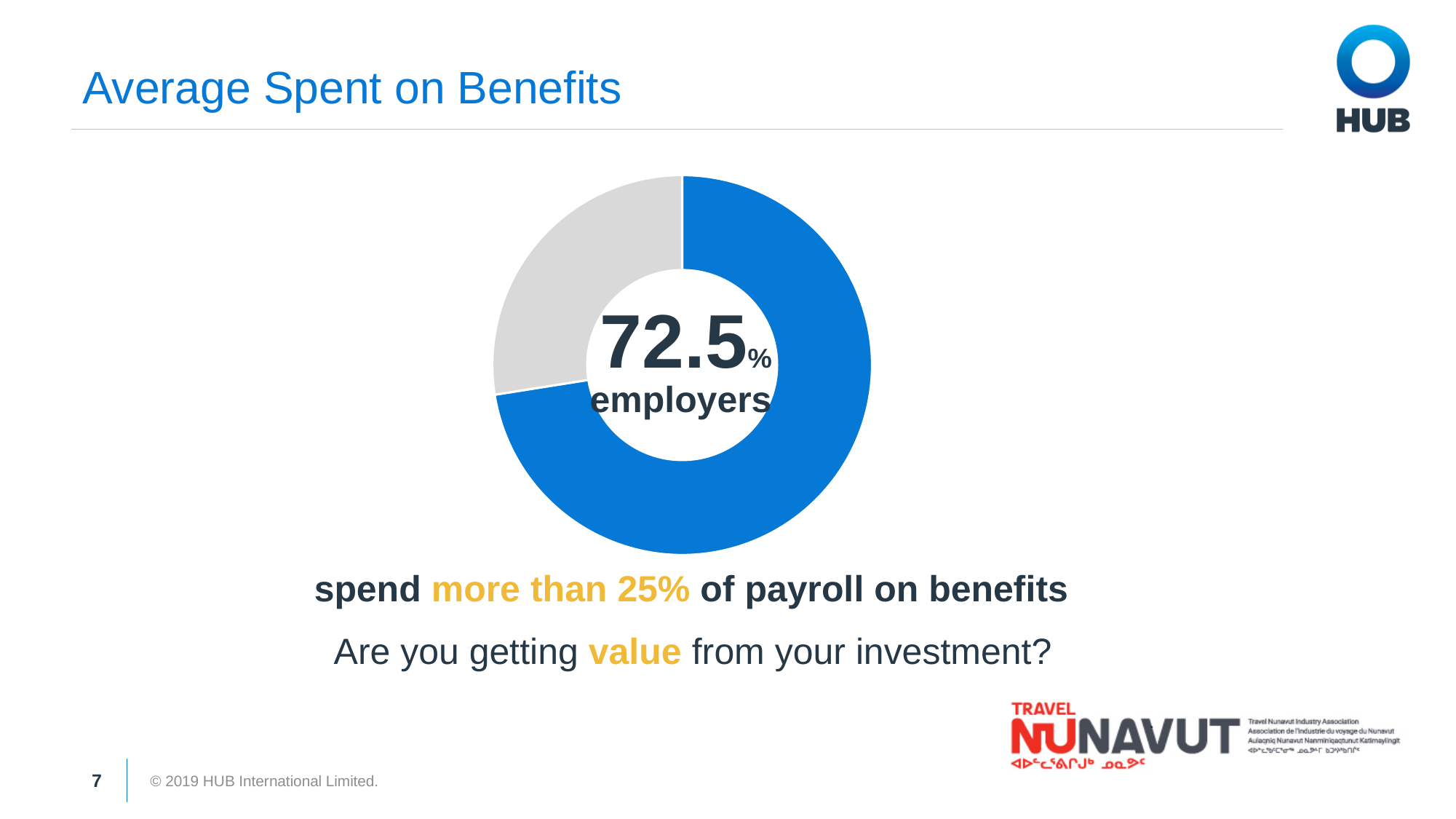
According to the slide, what do 72.5% of employers spend more than 25% of payroll on? benefits What kind of chart is shown on the slide? doughnut chart How many segments does the chart have? 2 What colour is the segment representing 72.5% of employers? blue Which segment is larger, the blue one or the grey one? blue What percentage of employers does the chart highlight? 72.5% Which segment of the chart is the smallest? the grey segment What is the title of the slide containing the chart? Average Spent on Benefits What share of the chart does the blue segment represent? 72.5%